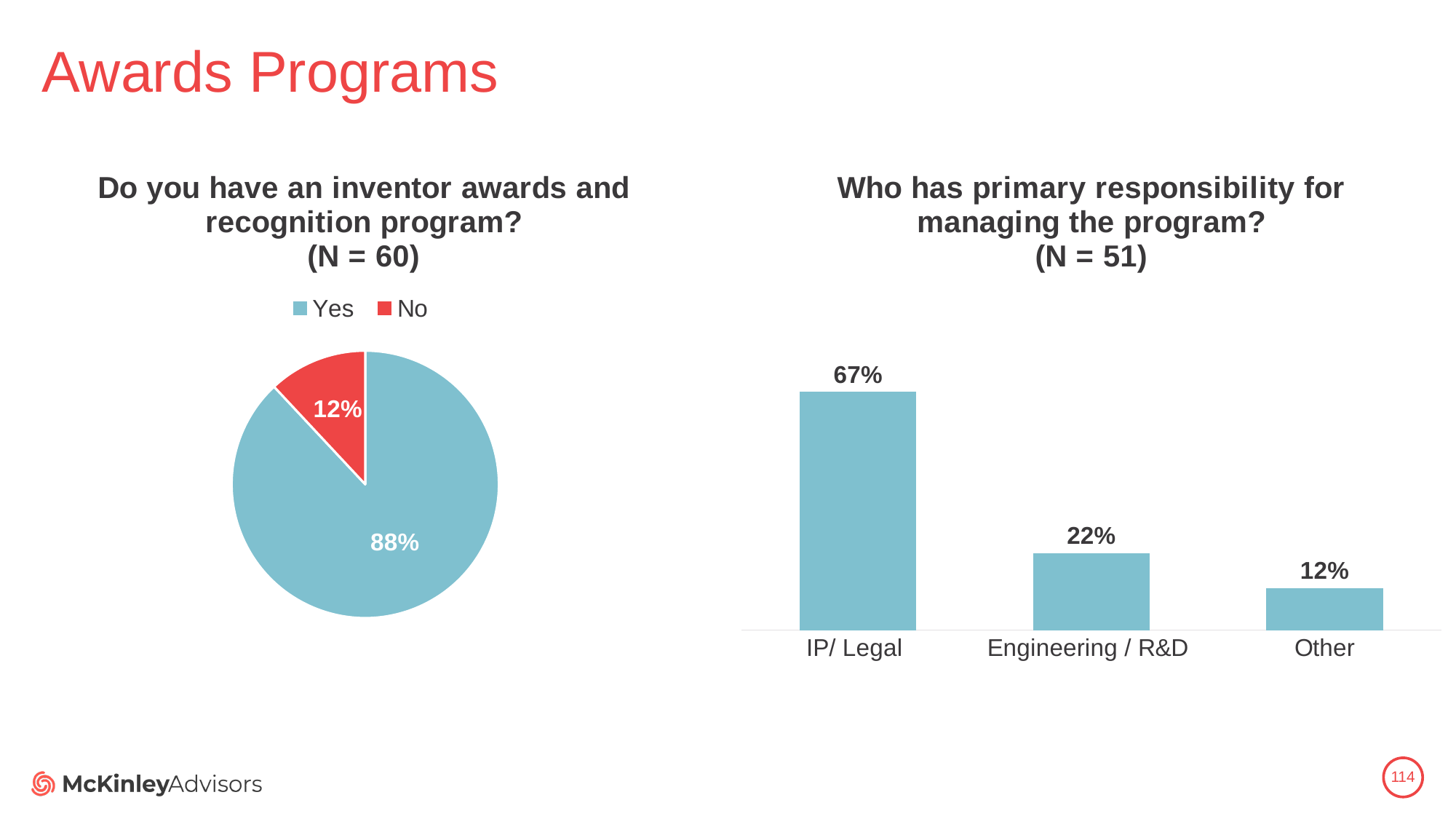
How many entries does the legend of the left chart list? 2 In the chart on the right, what is the value for IP/ Legal? 67% In the chart on the right, what is the value for Engineering / R&D? 22% In the chart on the right, which category has the lowest value? Other In the chart on the right, what is the value for Other? 12% In the pie chart on the left, what share of respondents answered No? 12% What kind of chart is the chart on the left? pie chart In the pie chart on the left, what share of respondents answered Yes? 88% In the chart on the right, which category has the highest value? IP/ Legal In the chart on the right, what is the difference between the values for IP/ Legal and Engineering / R&D? 45% In the left chart, what colour is the No slice? red What kind of chart is the chart on the right? bar chart